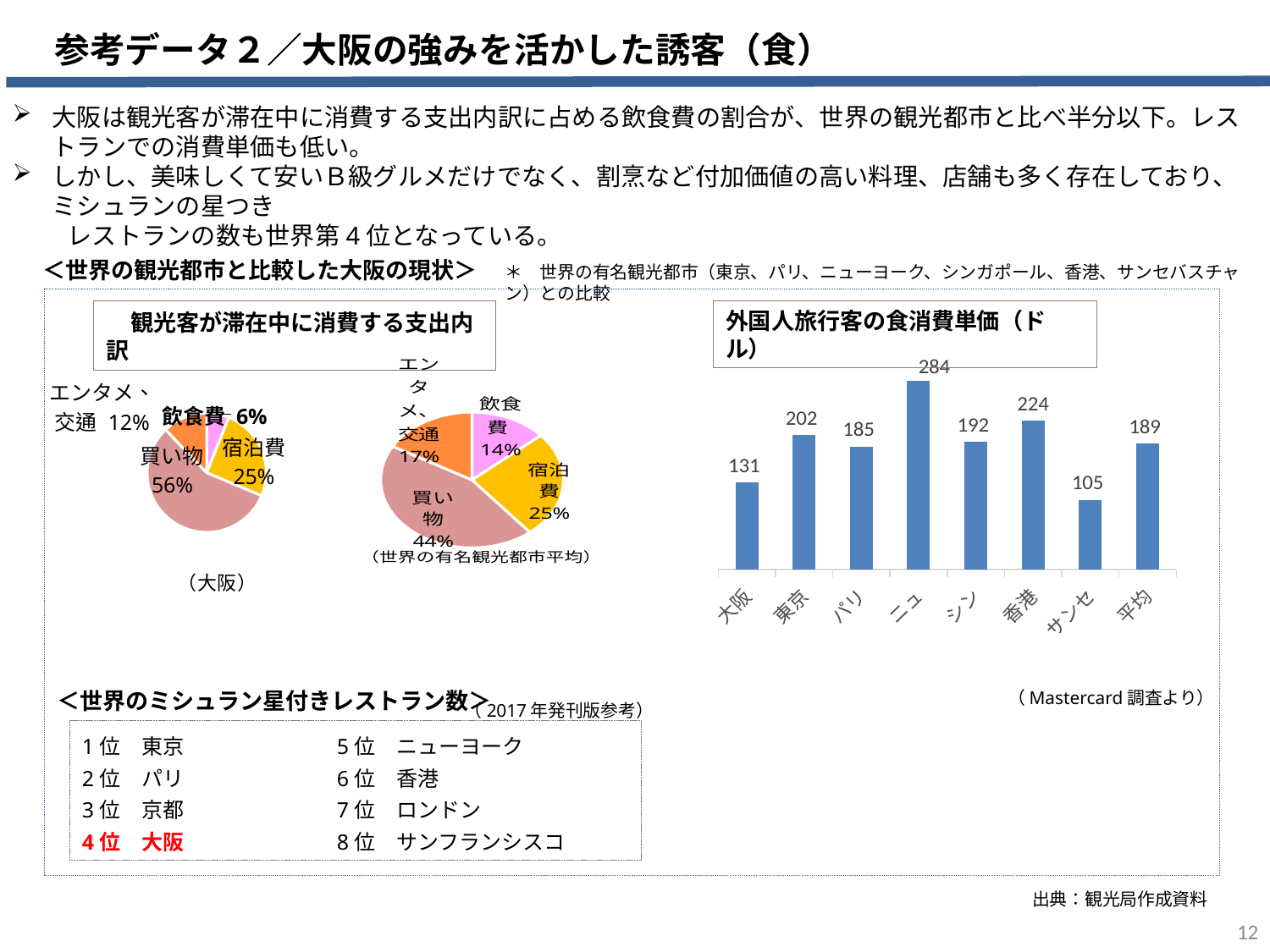
In the bar chart titled 外国人旅行客の食消費単価（ドル）, which category has the highest value? ニューヨーク (284) In the bar chart titled 外国人旅行客の食消費単価（ドル）, which is larger, the value for パリ or the value for 香港? 香港 In the bar chart titled 外国人旅行客の食消費単価（ドル）, what is the value for 香港? 224 What type of chart is the chart titled 外国人旅行客の食消費単価（ドル）? Bar chart In the bar chart titled 外国人旅行客の食消費単価（ドル）, which category has the lowest value? サンセバスチャン (105) In the pie chart for 世界の有名観光都市平均, what share does 買い物 have? 44% In the pie chart for 大阪 (観光客が滞在中に消費する支出内訳), what share does 飲食費 have? 6% In the bar chart titled 外国人旅行客の食消費単価（ドル）, what is the difference between the values for 東京 and 大阪? 71 In the bar chart titled 外国人旅行客の食消費単価（ドル）, what is the value for 平均? 189 How many bars are shown in the bar chart titled 外国人旅行客の食消費単価（ドル）? 8 In the bar chart titled 外国人旅行客の食消費単価（ドル）, what is the value for 大阪? 131 In the pie chart for 大阪 (観光客が滞在中に消費する支出内訳), which category has the largest share? 買い物 (56%)